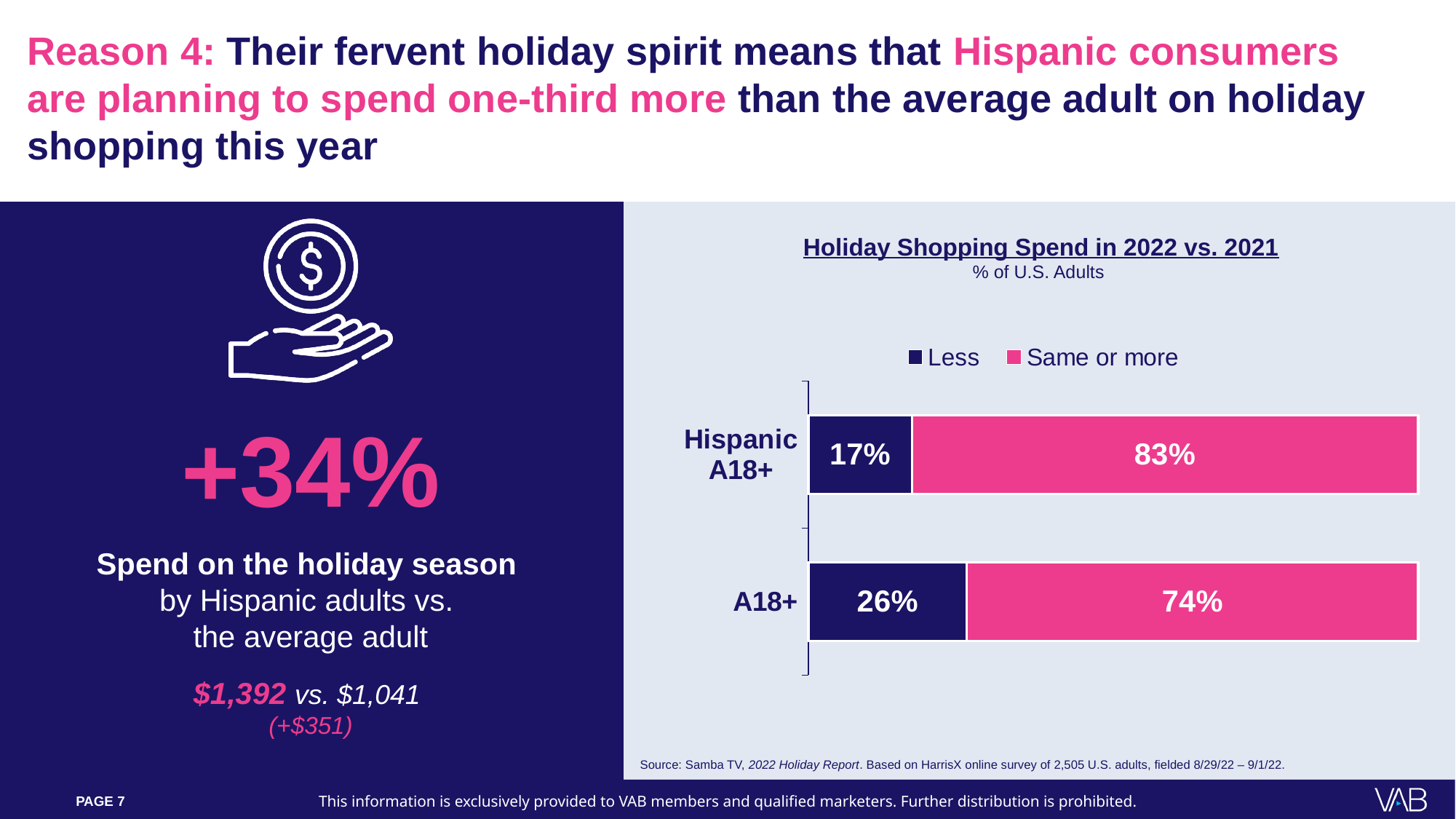
Which group has the higher share planning to spend the same or more: Hispanic A18+ or A18+? Hispanic A18+ What type of chart is shown on the slide? Stacked bar chart What percentage of Hispanic A18+ adults plan to spend the same or more on holiday shopping in 2022 vs. 2021? 83% What percentage of Hispanic A18+ adults plan to spend less on holiday shopping in 2022 vs. 2021? 17% What is the total of the two segments in the Hispanic A18+ bar? 100% How many series does the chart legend list? 2 What is the difference in percentage points between the 'Less' share for A18+ and for Hispanic A18+? 9 percentage points Which group has the lower share planning to spend less: Hispanic A18+ or A18+? Hispanic A18+ How many groups (categories) are shown in the chart? 2 What is the difference in percentage points between the 'Same or more' share for Hispanic A18+ and for A18+? 9 percentage points What percentage of A18+ adults plan to spend less on holiday shopping in 2022 vs. 2021? 26% What percentage of A18+ adults plan to spend the same or more on holiday shopping in 2022 vs. 2021? 74%